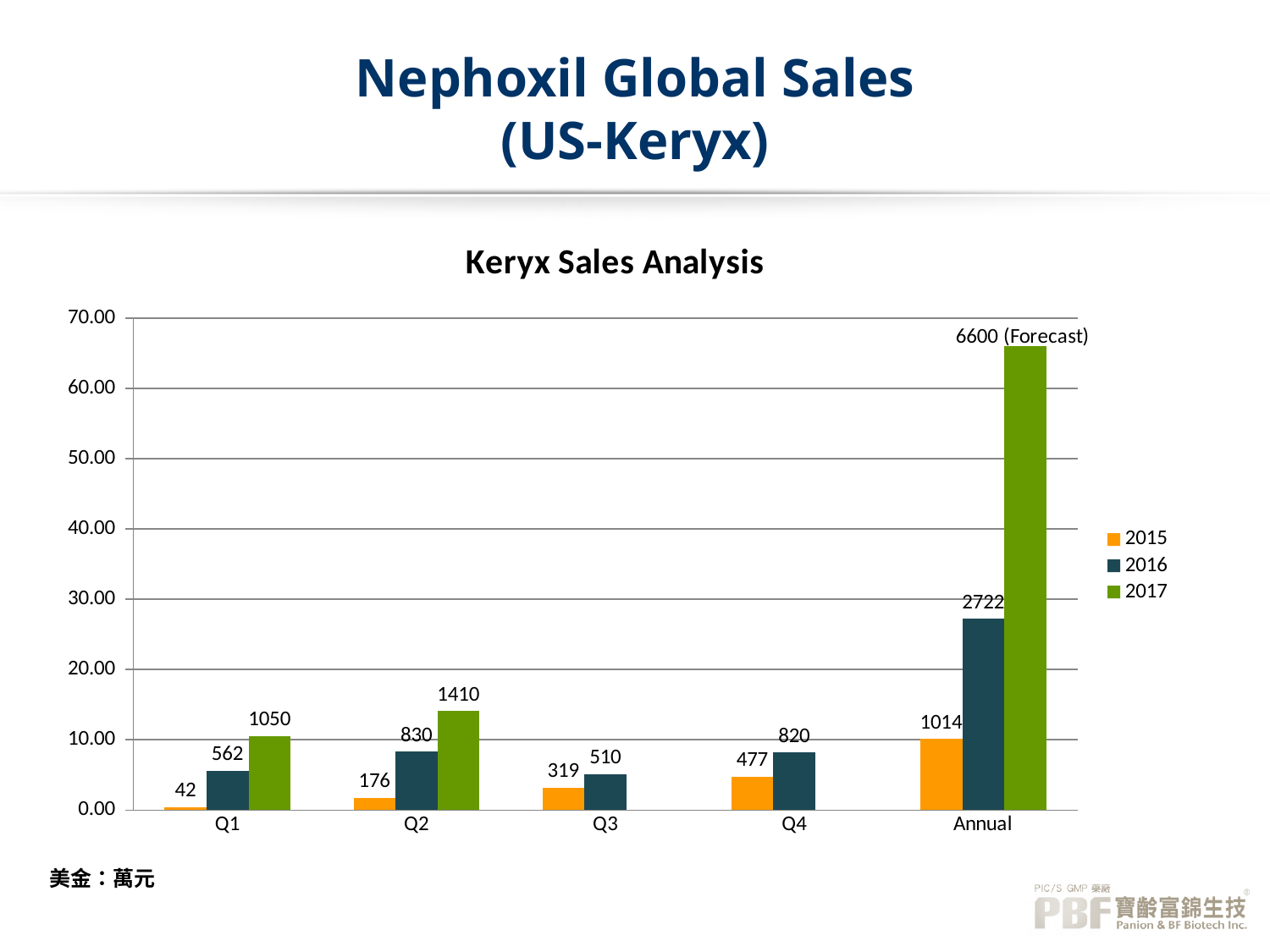
What is the value for 2016 in the Annual category on the Keryx Sales Analysis chart? 2722 What kind of chart is the Keryx Sales Analysis chart? Bar chart Which quarter has the highest value for the 2015 series on the Keryx Sales Analysis chart? Q4 Which is larger on the Keryx Sales Analysis chart: the 2016 value in Q4 or the 2016 value in Q3? 2016 value in Q4 Do the 2015 values rise or fall from Q1 to Q4 on the Keryx Sales Analysis chart? Rise What is the data label on the 2017 Annual bar on the Keryx Sales Analysis chart? 6600 (Forecast) What is the difference between the 2017 and 2016 values in Q2 on the Keryx Sales Analysis chart? 580 What is the value for 2016 in Q2 on the Keryx Sales Analysis chart? 830 How many series does the legend of the Keryx Sales Analysis chart list? 3 How many categories are shown on the x axis of the Keryx Sales Analysis chart? 5 What is the value for 2015 in Q1 on the Keryx Sales Analysis chart? 42 Which quarter has the lowest value for the 2016 series on the Keryx Sales Analysis chart? Q3